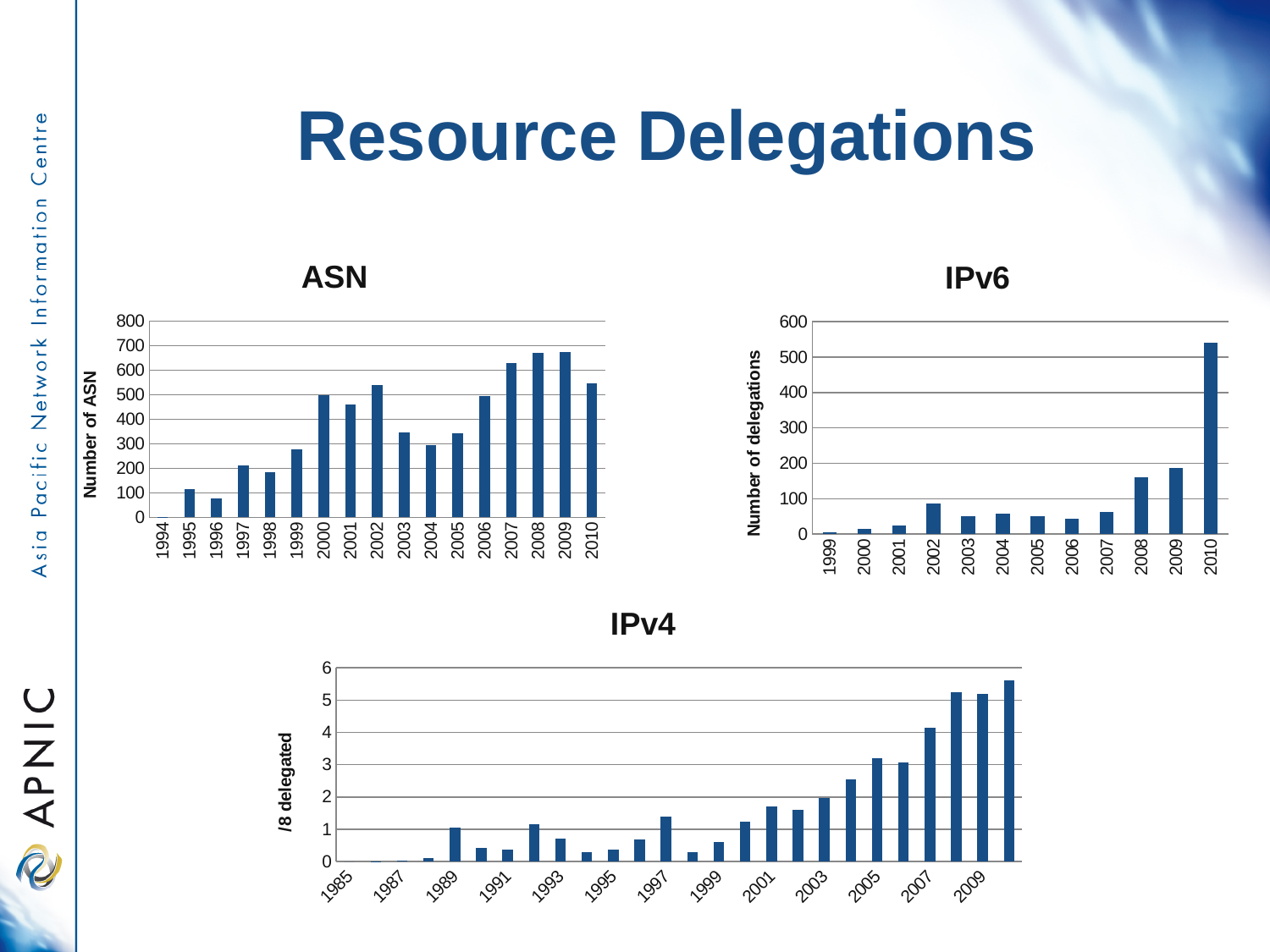
In the IPv4 chart, is the value for 2007 greater or less than 4? greater In the IPv6 chart, which year has the highest number of delegations? 2010 In the IPv6 chart, is the value for 2010 greater or less than 500? greater What is the y-axis title of the IPv4 chart? /8 delegated In the ASN chart, is the value for 1996 greater or less than 100? less In the ASN chart, which is larger, the value for 2002 or the value for 2003? 2002 In the ASN chart, which year has the lowest number of ASN? 1994 How many years are shown on the x axis of the IPv6 chart? 12 How many years are shown on the x axis of the ASN chart? 17 What type of chart is the ASN chart? bar chart